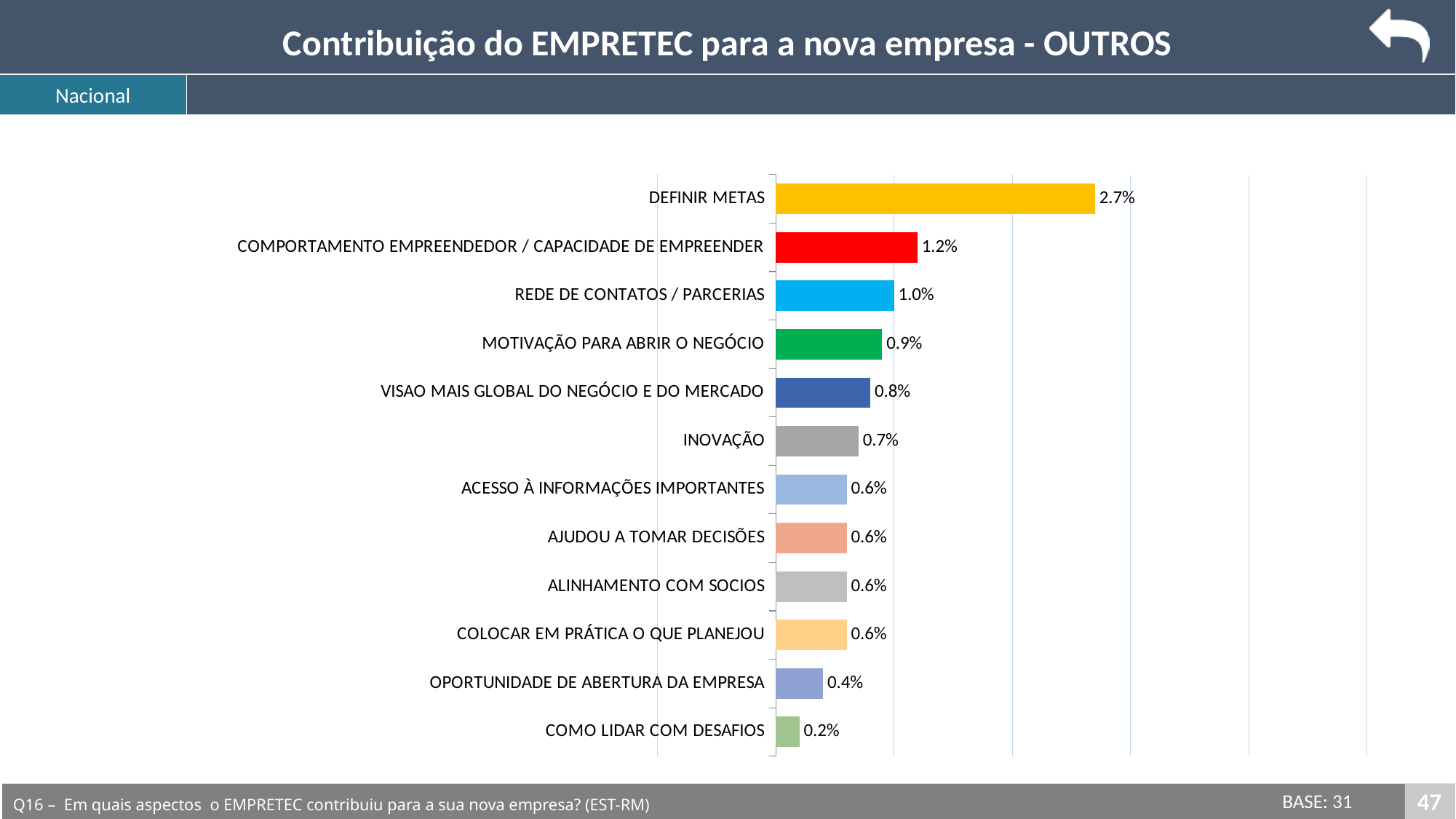
How many categories are shown in the chart? 12 What is the difference between the values for DEFINIR METAS and COMPORTAMENTO EMPREENDEDOR / CAPACIDADE DE EMPREENDER? 1.5% Which category has the lowest value? COMO LIDAR COM DESAFIOS What is the value for DEFINIR METAS? 2.7% Which category has the highest value? DEFINIR METAS What is the value for OPORTUNIDADE DE ABERTURA DA EMPRESA? 0.4% Which is larger, the value for COMPORTAMENTO EMPREENDEDOR / CAPACIDADE DE EMPREENDER or the value for VISAO MAIS GLOBAL DO NEGÓCIO E DO MERCADO? COMPORTAMENTO EMPREENDEDOR / CAPACIDADE DE EMPREENDER What is the difference between the values for MOTIVAÇÃO PARA ABRIR O NEGÓCIO and COMO LIDAR COM DESAFIOS? 0.7% What is the value for INOVAÇÃO? 0.7% What is the value for REDE DE CONTATOS / PARCERIAS? 1.0% What kind of chart is shown on the slide? Bar chart What colour is the bar for DEFINIR METAS? Yellow